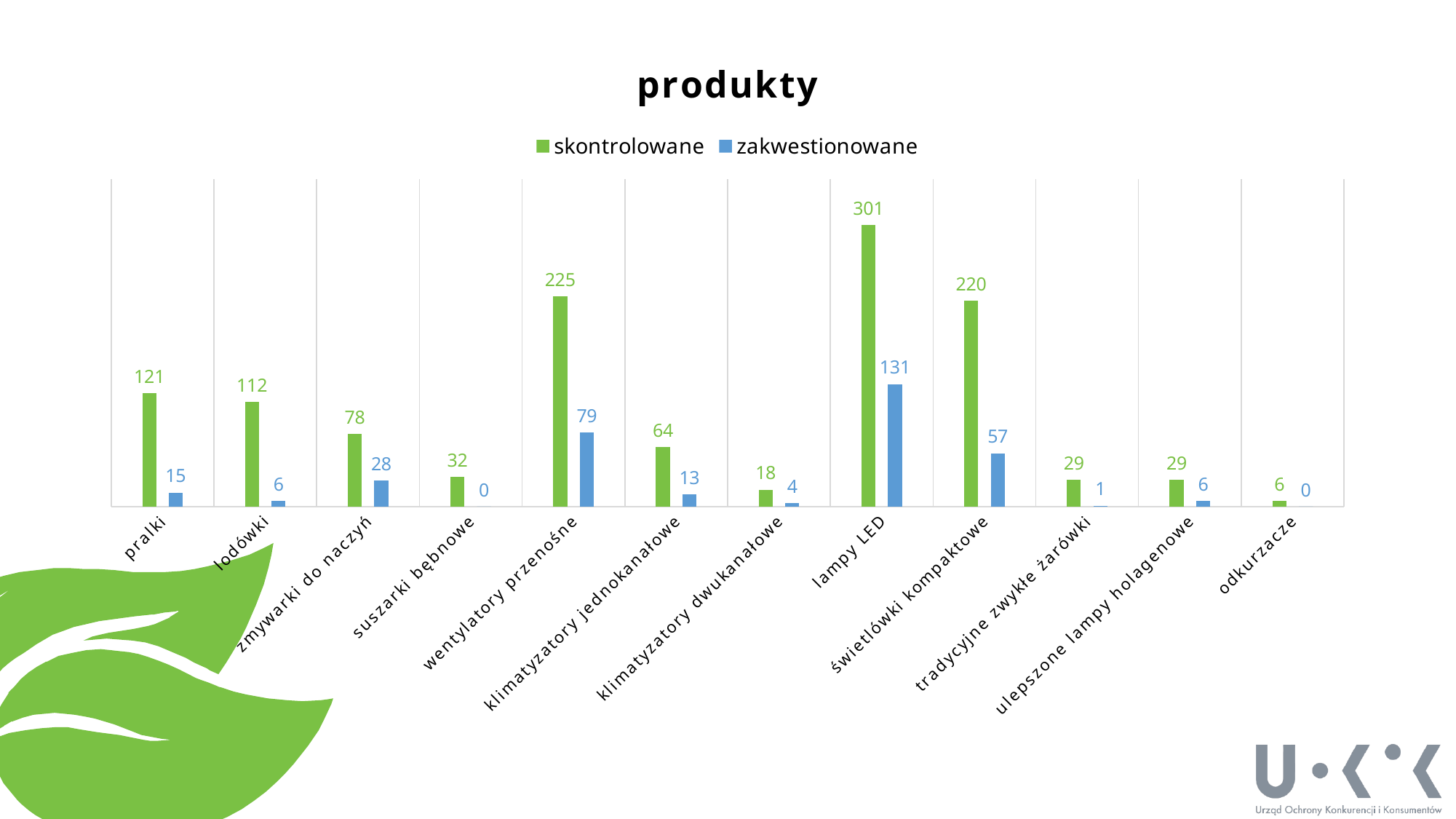
What is the title of the chart? produkty What is the skontrolowane value for lampy LED? 301 What is the zakwestionowane value for zmywarki do naczyń? 28 What kind of chart is shown on the slide? bar chart Which category has the lowest skontrolowane value? odkurzacze How many product categories are shown on the x axis? 12 Which category has the highest skontrolowane value? lampy LED What is the difference between the skontrolowane and zakwestionowane values for świetlówki kompaktowe? 163 What is the zakwestionowane value for wentylatory przenośne? 79 Which colour represents the zakwestionowane series? blue Which is larger: the skontrolowane value for pralki or for lodówki? pralki How many series does the legend list? 2